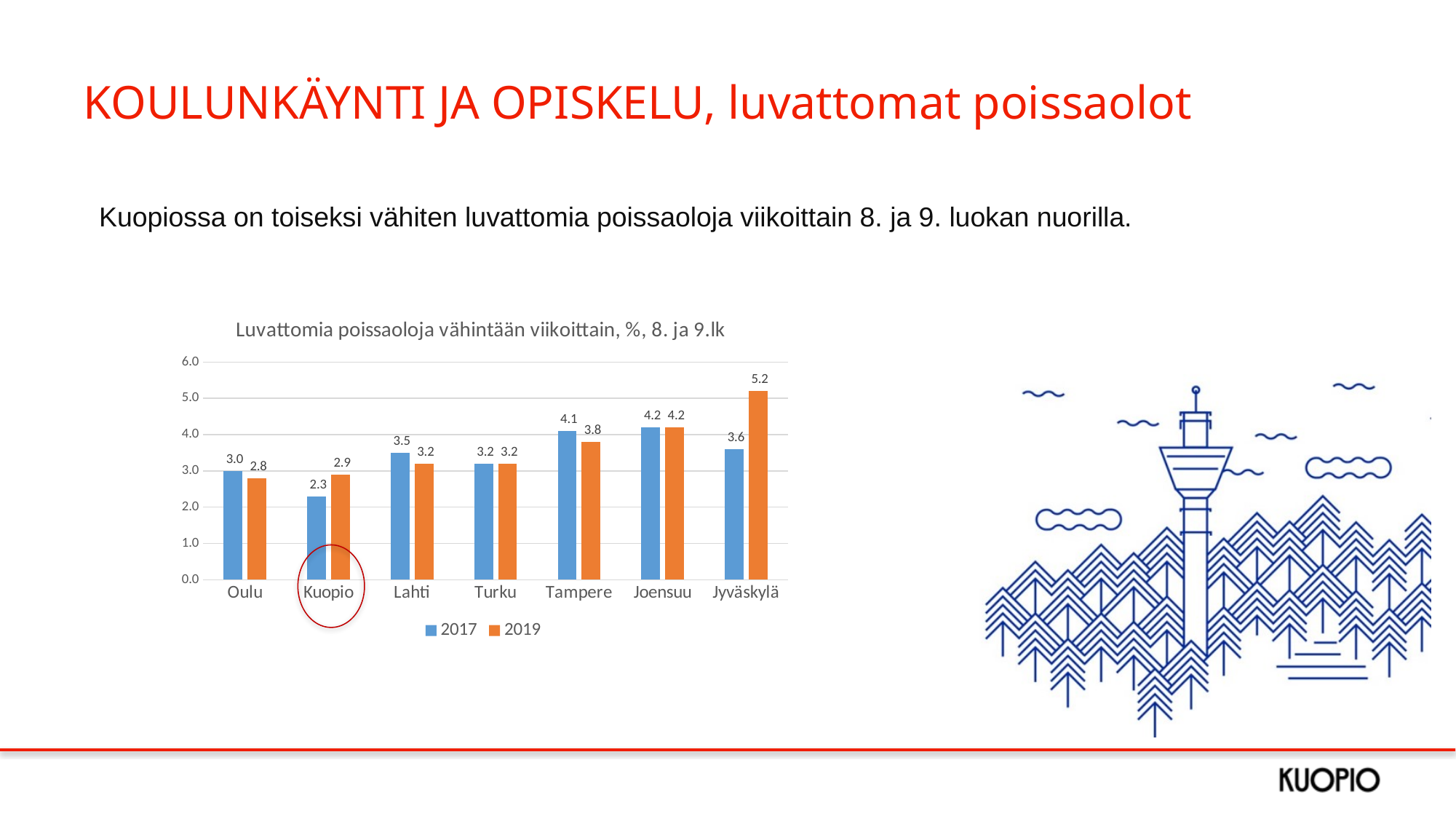
What is the 2019 value for Kuopio? 2.9 What is the title of the chart? Luvattomia poissaoloja vähintään viikoittain, %, 8. ja 9.lk Which city is circled in red on the chart? Kuopio Which city has the lowest 2017 value? Kuopio What is the difference between the 2019 and 2017 values for Jyväskylä? 1.6 Which city has the highest 2019 value? Jyväskylä Which is larger for Lahti, the 2017 value or the 2019 value? 2017 How many series does the legend list? 2 What kind of chart is shown? bar chart How many cities are shown on the x axis? 7 Is the 2019 value for Jyväskylä greater or less than 5.0? greater What is the 2017 value for Tampere? 4.1